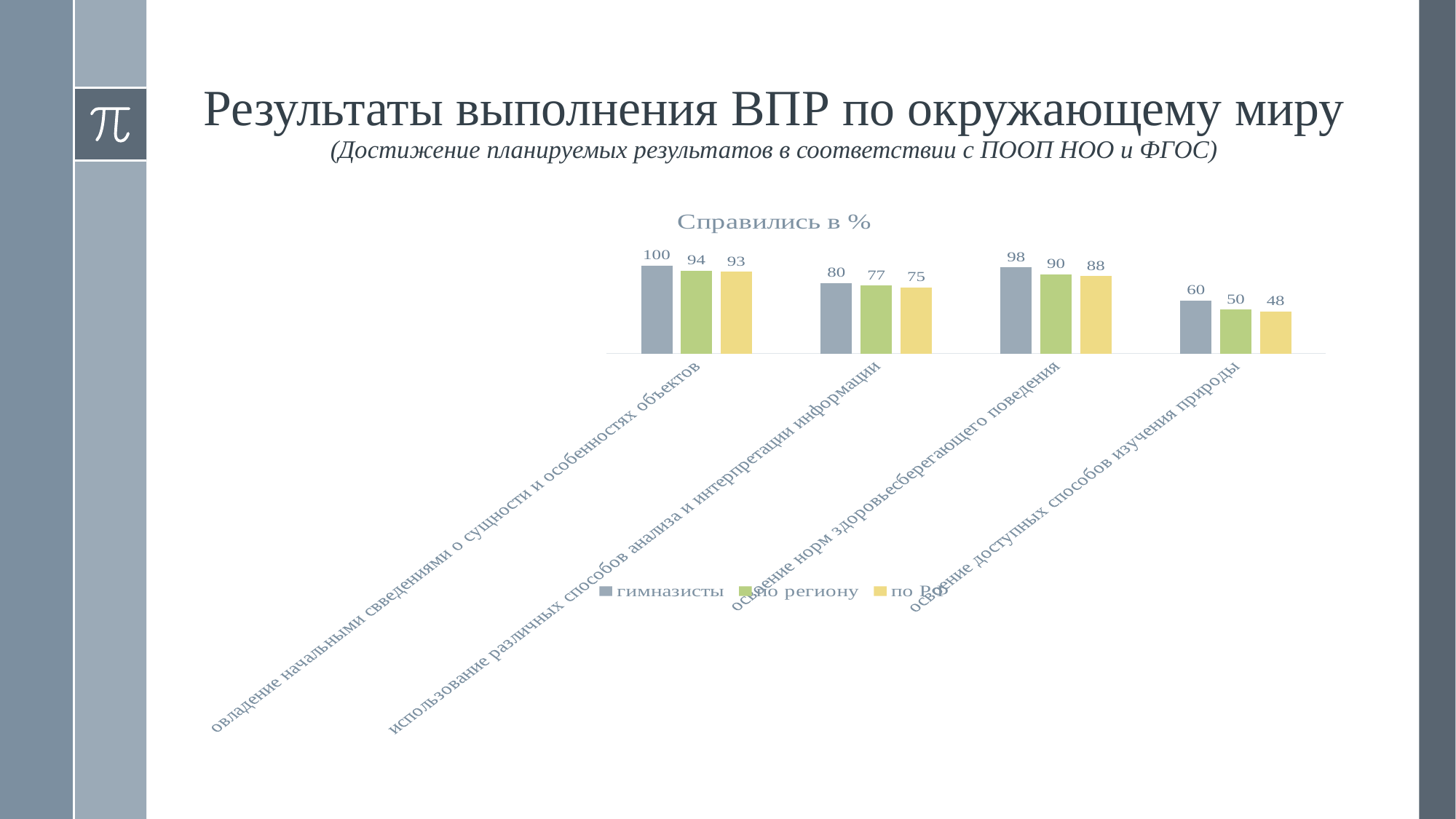
In which category is the value for по РФ the highest? овладение начальными сведениями о сущности и особенностях объектов What is the title of the chart? Справились в % Which is larger in the category 'освоение доступных способов изучения природы': гимназисты or по региону? гимназисты What is the value for по региону in the category 'освоение норм здоровьесберегающего поведения'? 90 How many categories are shown on the x axis? 4 Which series is shown in yellow? по РФ What is the difference between гимназисты and по РФ in the category 'использование различных способов анализа и интерпретации информации'? 5 What is the value for гимназисты in the category 'овладение начальными сведениями о сущности и особенностях объектов'? 100 How many series does the legend list? 3 What is the value for по РФ in the category 'освоение доступных способов изучения природы'? 48 What type of chart is shown on the slide? bar chart In which category is the value for гимназисты the lowest? освоение доступных способов изучения природы